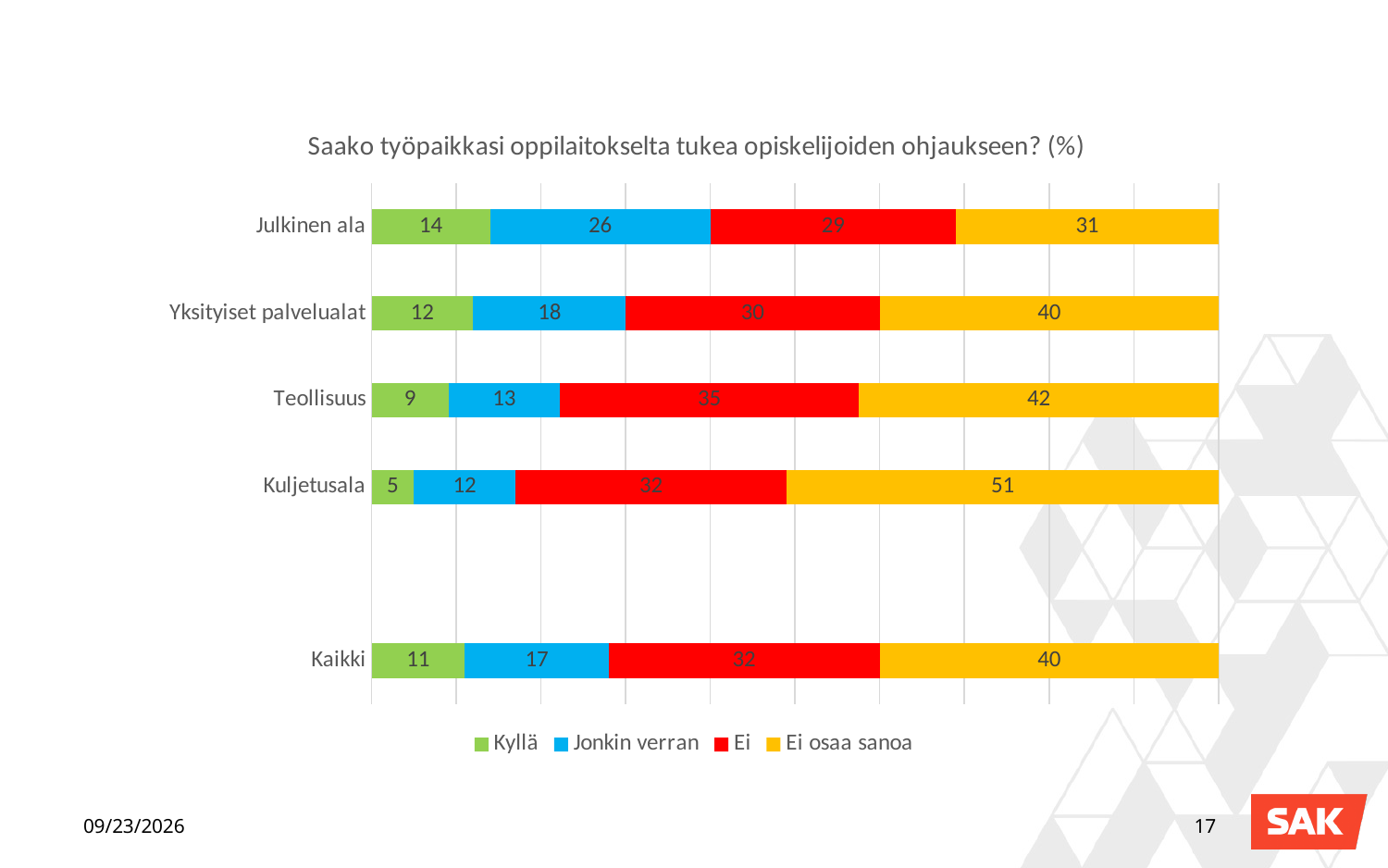
What is the value of "Ei osaa sanoa" for Kuljetusala? 51 How many series does the legend list? 4 Which category has the highest value for "Ei osaa sanoa"? Kuljetusala Which is larger: the "Jonkin verran" value for Julkinen ala or for Yksityiset palvelualat? Julkinen ala What kind of chart is shown on the slide? Stacked bar chart What is the value of "Kyllä" for Julkinen ala? 14 What is the total of the stacked bar for Teollisuus? 99 What is the value of "Ei" for Teollisuus? 35 What is the difference between the "Ei osaa sanoa" values for Kuljetusala and Julkinen ala? 20 How many categories are shown on the chart? 5 Which category has the lowest value for "Kyllä"? Kuljetusala What is the value of "Jonkin verran" for Kaikki? 17